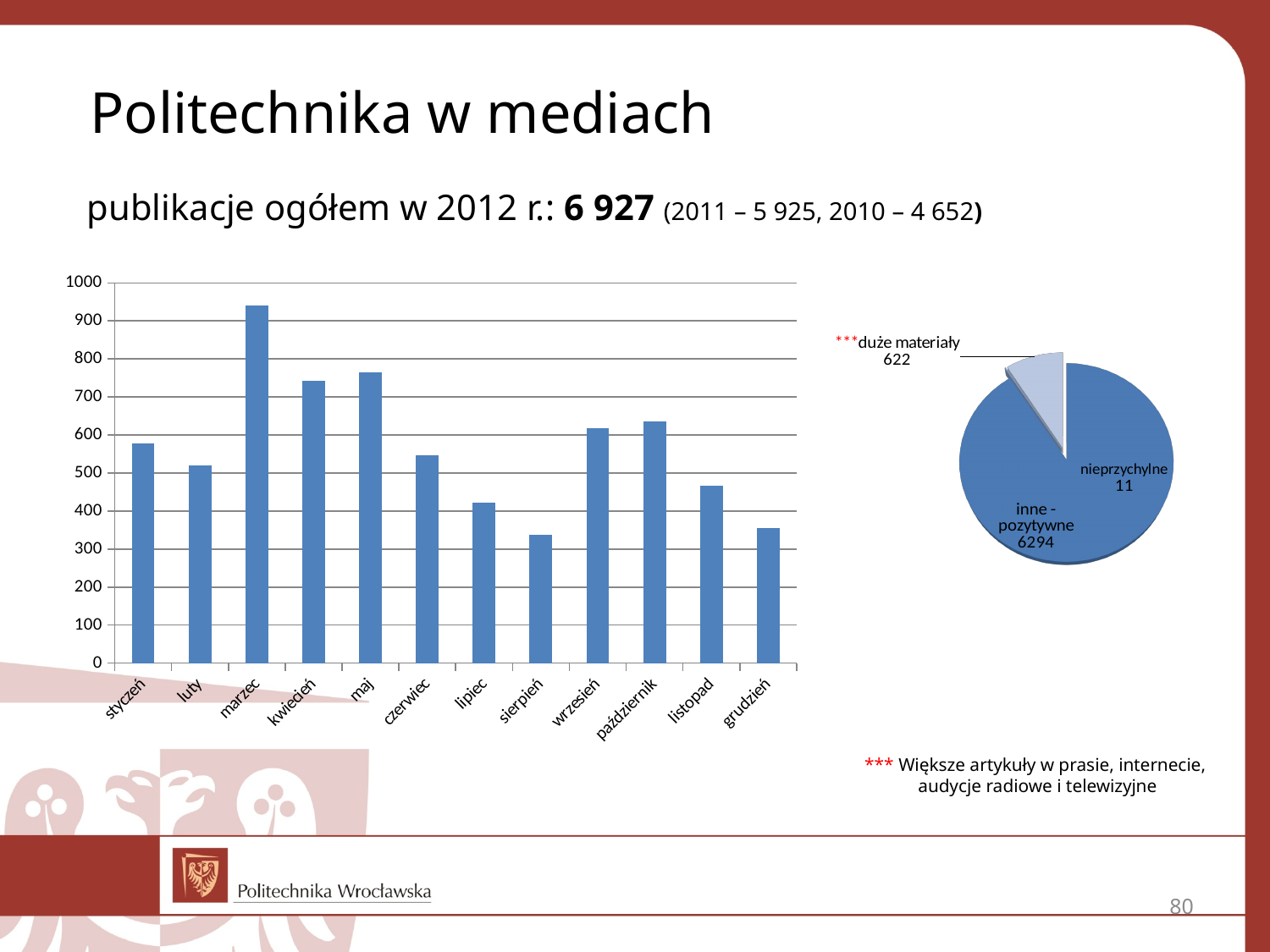
In the bar chart on the left, how many months are shown on the x axis? 12 In the bar chart on the left, which month has the highest value? marzec What kind of chart is the chart on the left side of the slide? bar chart What kind of chart is the chart on the right side of the slide? pie chart In the pie chart on the right, what is the value for 'inne - pozytywne'? 6294 In the bar chart on the left, which is larger, the value for sierpień or the value for wrzesień? wrzesień In the bar chart on the left, which is larger, the value for marzec or the value for maj? marzec In the bar chart on the left, is the value for sierpień greater or less than 400? less In the bar chart on the left, is the value for kwiecień greater or less than 700? greater In the pie chart on the right, what is the value for 'nieprzychylne'? 11 In the bar chart on the left, is the value for marzec greater or less than 900? greater In the pie chart on the right, what is the value for 'duże materiały'? 622